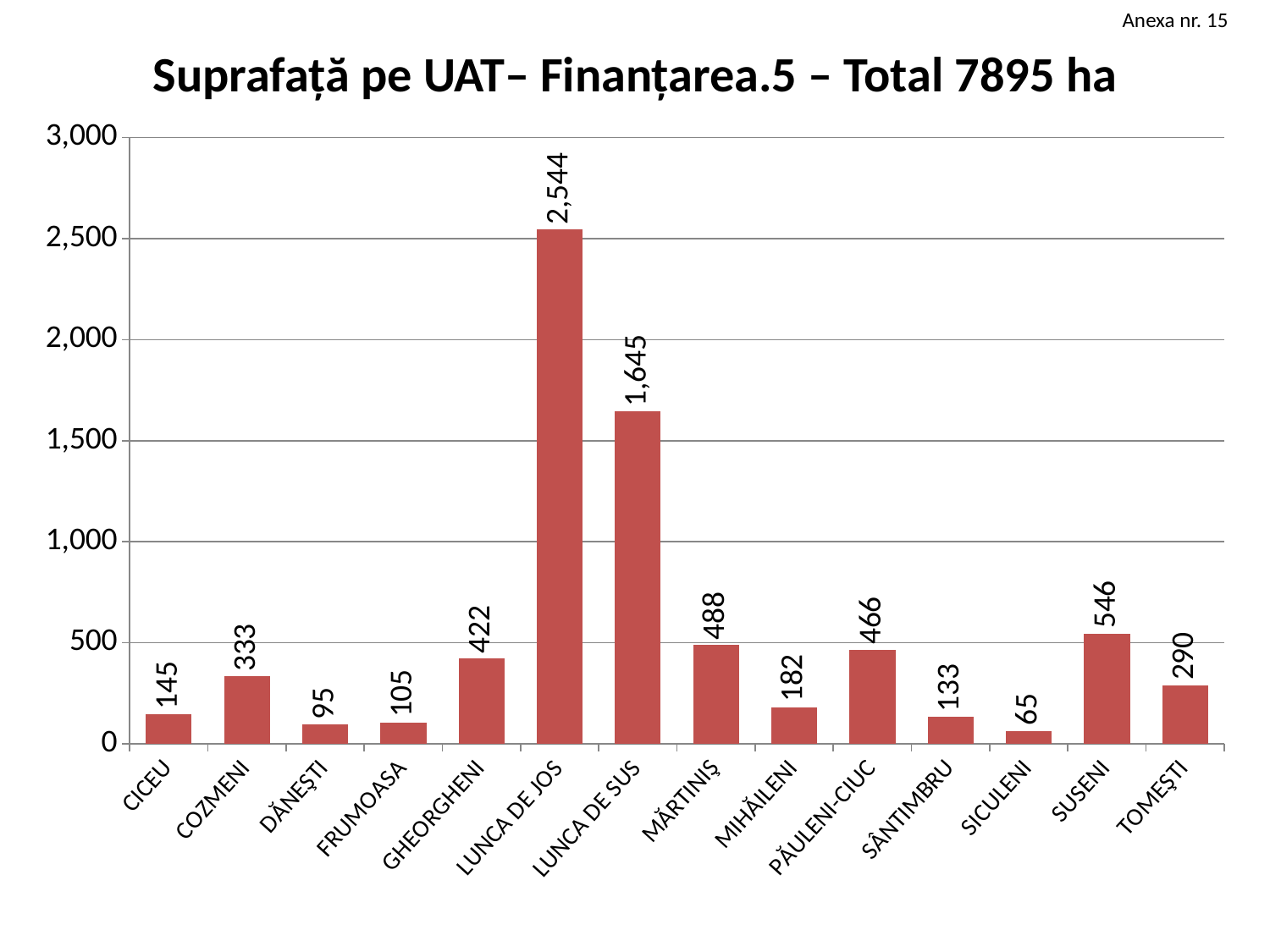
Which category has the lowest value? SICULENI What is the difference between the values for COZMENI and CICEU? 188 What is the value for LUNCA DE JOS? 2,544 How many categories are shown on the x axis? 14 What is the value for GHEORGHENI? 422 What is the value for SICULENI? 65 Is the value for PĂULENI-CIUC greater or less than 500? less What kind of chart is shown on the slide? bar chart Which is larger, the value for SUSENI or the value for MĂRTINIŞ? SUSENI What is the title of the chart? Suprafață pe UAT– Finanțarea.5 – Total 7895 ha Which category has the highest value? LUNCA DE JOS What is the difference between the values for LUNCA DE JOS and LUNCA DE SUS? 899